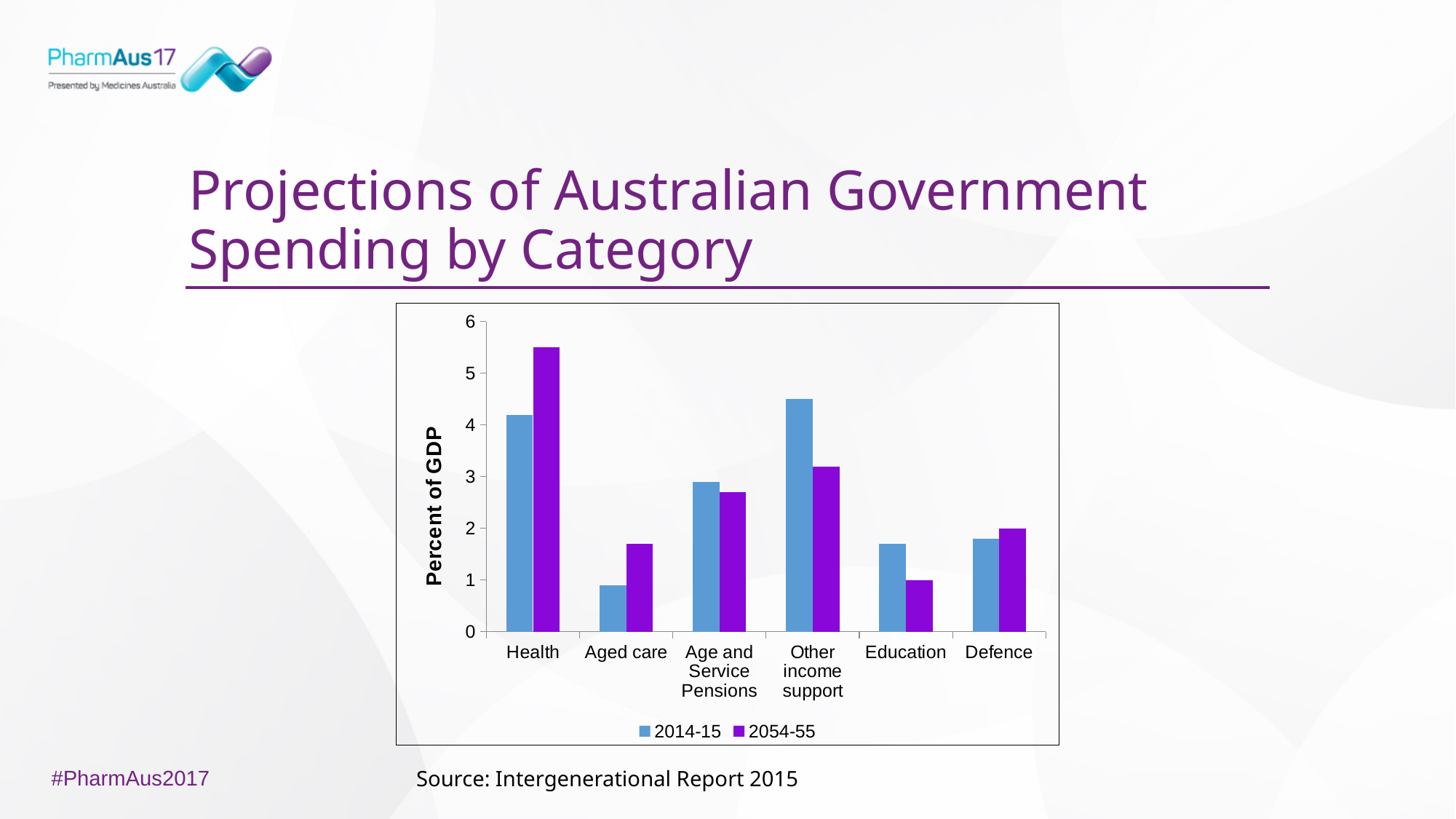
Which category has the highest value for 2054-55? Health Is the 2014-15 value for Other income support greater or less than 4? greater For Aged care, which series has the larger value, 2014-15 or 2054-55? 2054-55 What kind of chart is shown on the slide? Bar chart How many series does the legend list? 2 Is the 2054-55 value for Aged care greater or less than 2? less Which category has the lowest value for 2014-15? Aged care What is the label on the vertical axis of the chart? Percent of GDP Which category has the lowest value for 2054-55? Education For Other income support, which series has the larger value, 2014-15 or 2054-55? 2014-15 Is the 2054-55 value for Health greater or less than 5? greater How many spending categories are shown on the x axis? 6